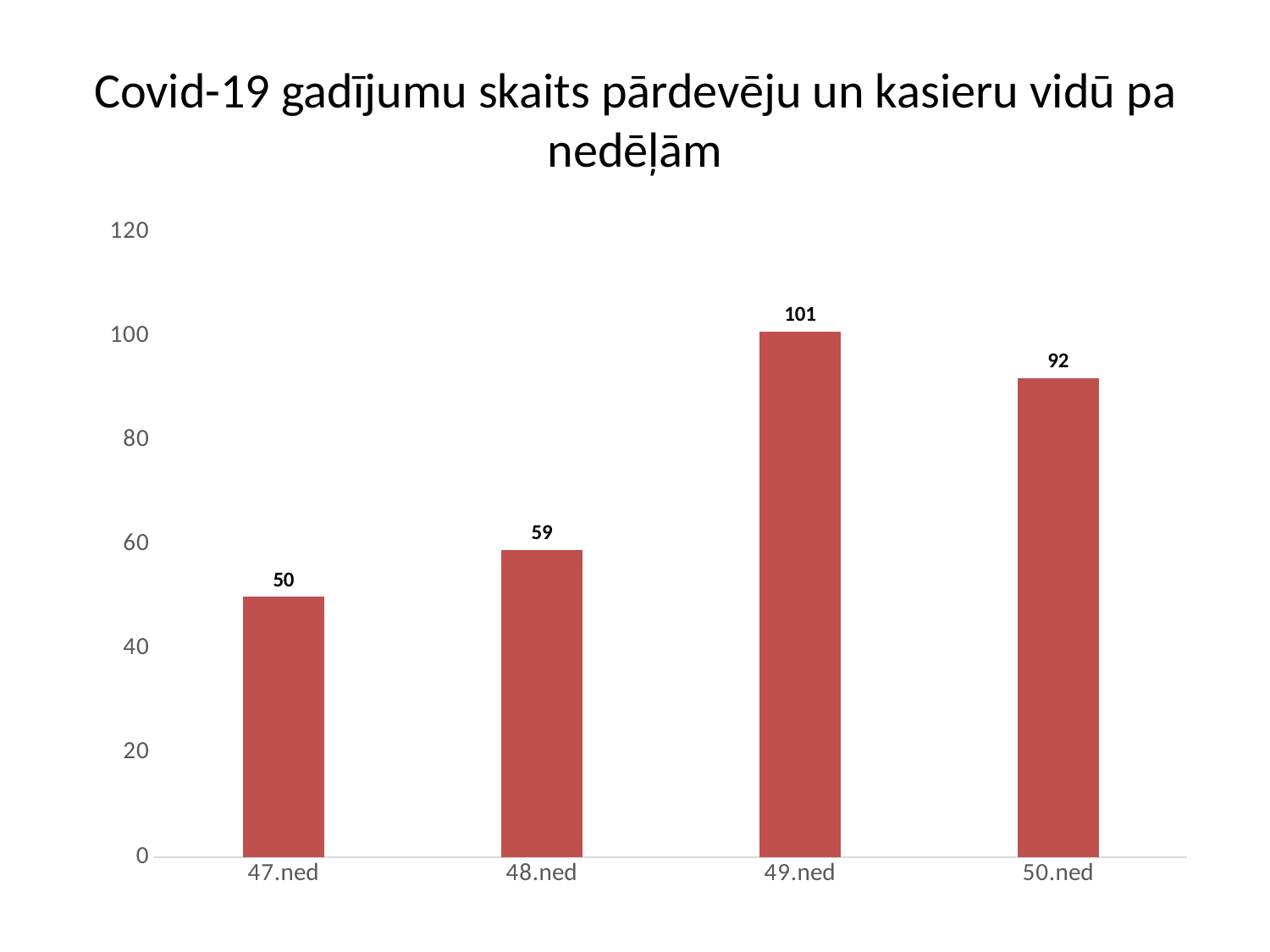
What kind of chart is shown on the slide? bar chart Which week has the lowest number of cases? 47.ned What is the value for 50.ned? 92 What is the difference between the values for 48.ned and 47.ned? 9 Which is larger, the value for 48.ned or the value for 50.ned? 50.ned What is the difference between the values for 49.ned and 50.ned? 9 Is the value for 49.ned greater or less than 100? greater What is the title of the chart? Covid-19 gadījumu skaits pārdevēju un kasieru vidū pa nedēļām What is the value for 47.ned? 50 How many weeks are shown on the x axis? 4 Which week has the highest number of cases? 49.ned What is the value for 49.ned? 101